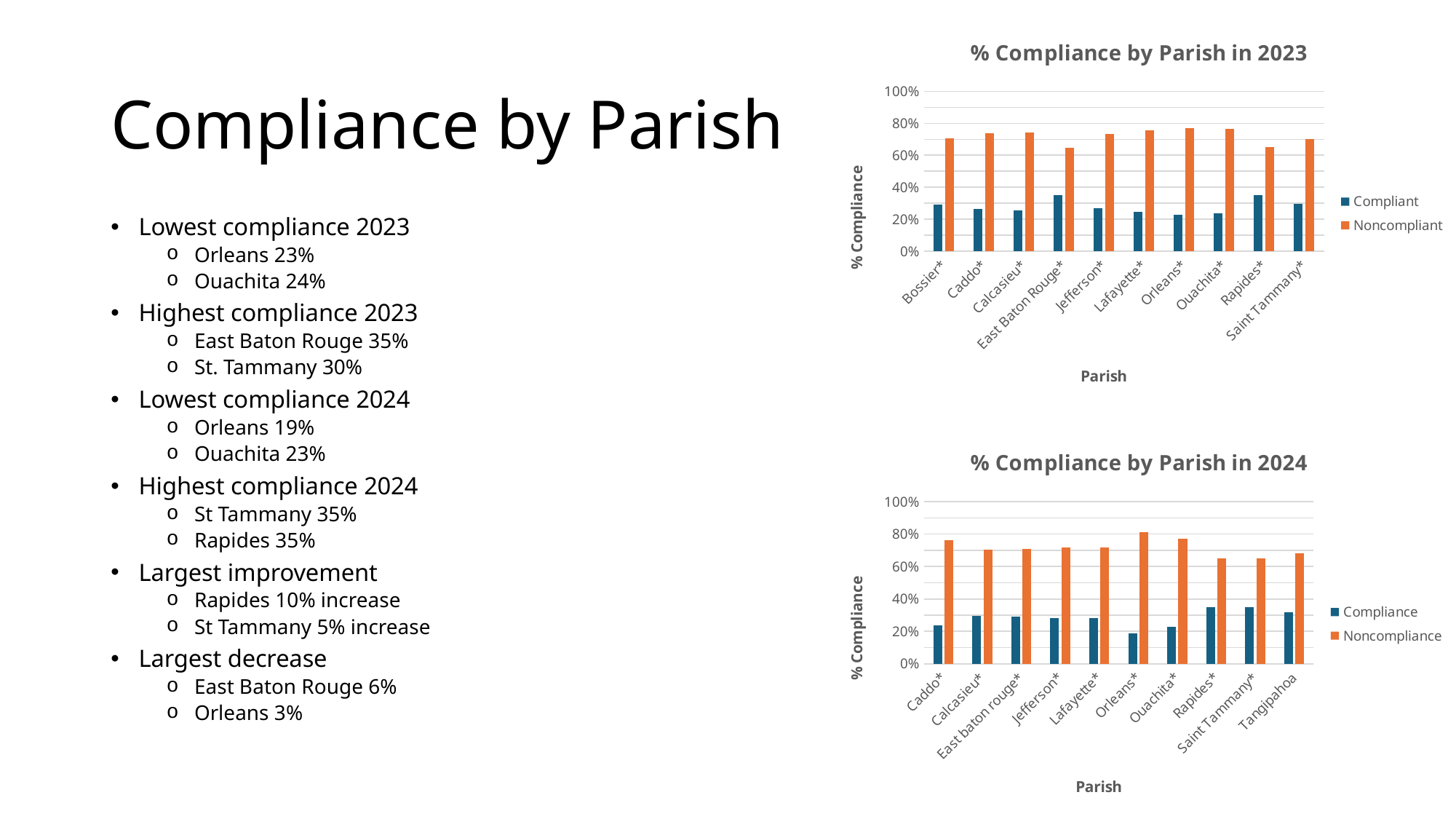
How many series does the legend of '% Compliance by Parish in 2024' list? 2 What is the y-axis title of '% Compliance by Parish in 2023'? % Compliance In '% Compliance by Parish in 2024', is the Compliance value for Tangipahoa greater or less than 20%? greater In '% Compliance by Parish in 2023', is the Compliant value for East Baton Rouge* greater or less than 40%? less In '% Compliance by Parish in 2024', which parish has the highest Noncompliance value? Orleans* In '% Compliance by Parish in 2024', which parish has the lowest Compliance value? Orleans* How many parishes are shown on the x axis of '% Compliance by Parish in 2023'? 10 In '% Compliance by Parish in 2024', which is larger for Orleans*: Compliance or Noncompliance? Noncompliance In '% Compliance by Parish in 2023', is the Noncompliant value for Bossier* greater or less than 60%? greater What kind of chart is '% Compliance by Parish in 2023'? bar chart In '% Compliance by Parish in 2024', which parish has the larger Compliance value: Orleans* or Tangipahoa? Tangipahoa How many parishes are shown on the x axis of '% Compliance by Parish in 2024'? 10